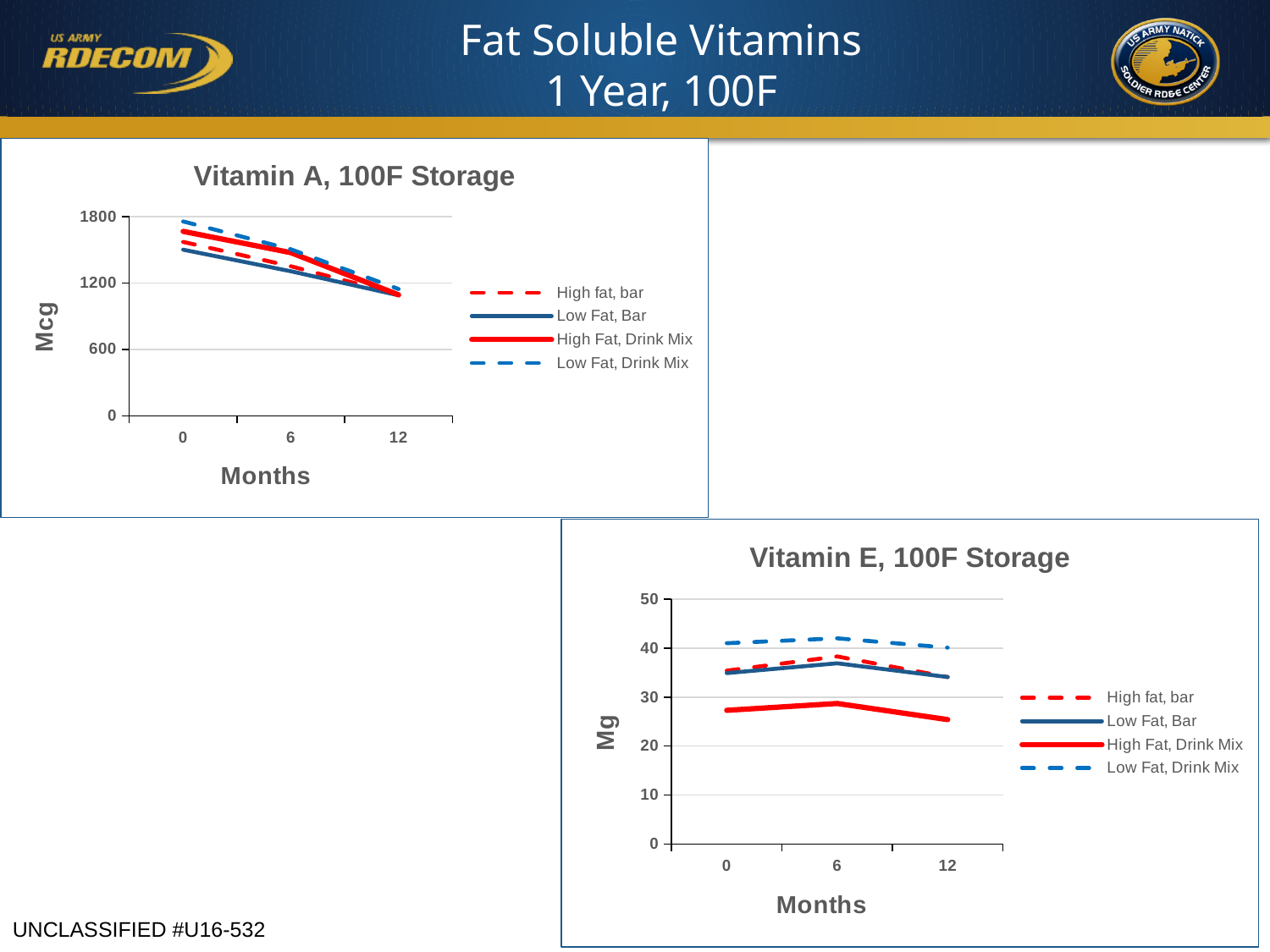
In the 'Vitamin A, 100F Storage' chart, do the values for Low Fat, Bar rise or fall from 0 to 12 months? fall In the 'Vitamin A, 100F Storage' chart, is the value for Low Fat, Bar at 0 months greater or less than 1800? less In the 'Vitamin E, 100F Storage' chart, which series has the lowest values across all months? High Fat, Drink Mix In the 'Vitamin A, 100F Storage' chart, is the value for High Fat, Drink Mix at 12 months greater or less than 1200? less How many month values are shown on the x axis of the 'Vitamin A, 100F Storage' chart? 3 In the 'Vitamin E, 100F Storage' chart, which is larger at 6 months: Low Fat, Drink Mix or Low Fat, Bar? Low Fat, Drink Mix How many series does the legend of the 'Vitamin E, 100F Storage' chart list? 4 In the 'Vitamin E, 100F Storage' chart, is the value for High Fat, Drink Mix at 12 months greater or less than 30? less What is the y-axis label of the 'Vitamin E, 100F Storage' chart? Mg What type of chart is the 'Vitamin A, 100F Storage' chart? line chart In the 'Vitamin A, 100F Storage' chart, which series has the highest value at 0 months? Low Fat, Drink Mix